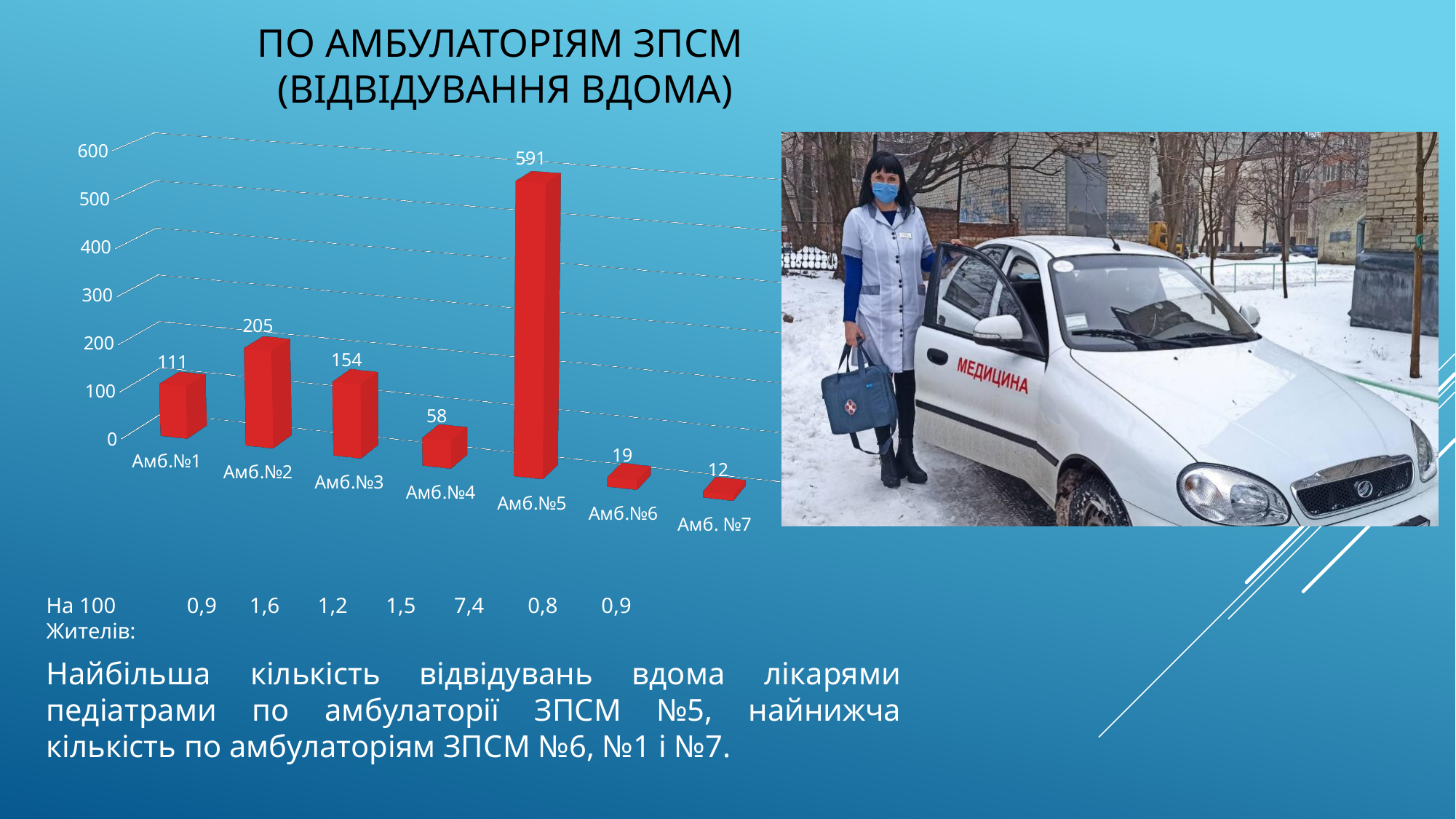
Which category has the highest value? Амб.№5 What is the difference between the values for Амб.№3 and Амб.№1? 43 What is the value for Амб.№5? 591 What is the value for Амб.№4? 58 What kind of chart is shown on the slide? Bar chart Which is larger, the value for Амб.№1 or the value for Амб.№3? Амб.№3 What is the difference between the values for Амб.№5 and Амб.№2? 386 What is the value for Амб.№2? 205 What is the value for Амб. №7? 12 Which category has the lowest value? Амб. №7 How many categories are shown on the chart? 7 What is the title of the chart? ПО АМБУЛАТОРІЯМ ЗПСМ (ВІДВІДУВАННЯ ВДОМА)